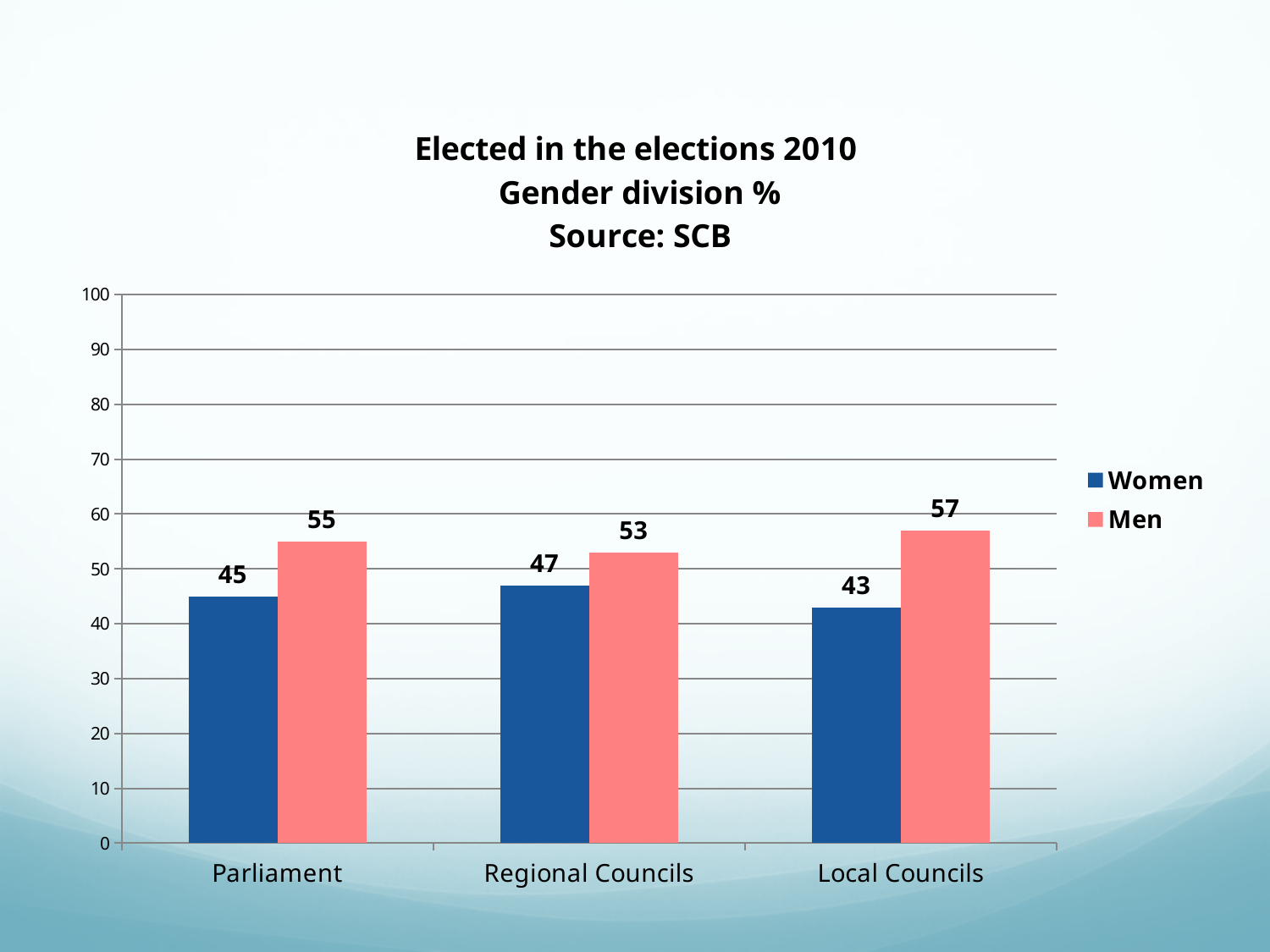
In which category is the value for Women highest? Regional Councils Is the value for Men in Regional Councils greater or less than 50? greater What is the value for Women in Parliament? 45 How many series does the legend list? 2 What is the difference between Men and Women in Local Councils? 14 What is the value for Women in Regional Councils? 47 In which category is the value for Men lowest? Regional Councils What is the value for Men in Local Councils? 57 Which is larger in Parliament, the value for Women or the value for Men? Men What kind of chart is shown on the slide? Bar chart Which series is shown in dark blue? Women How many categories are shown on the x axis? 3